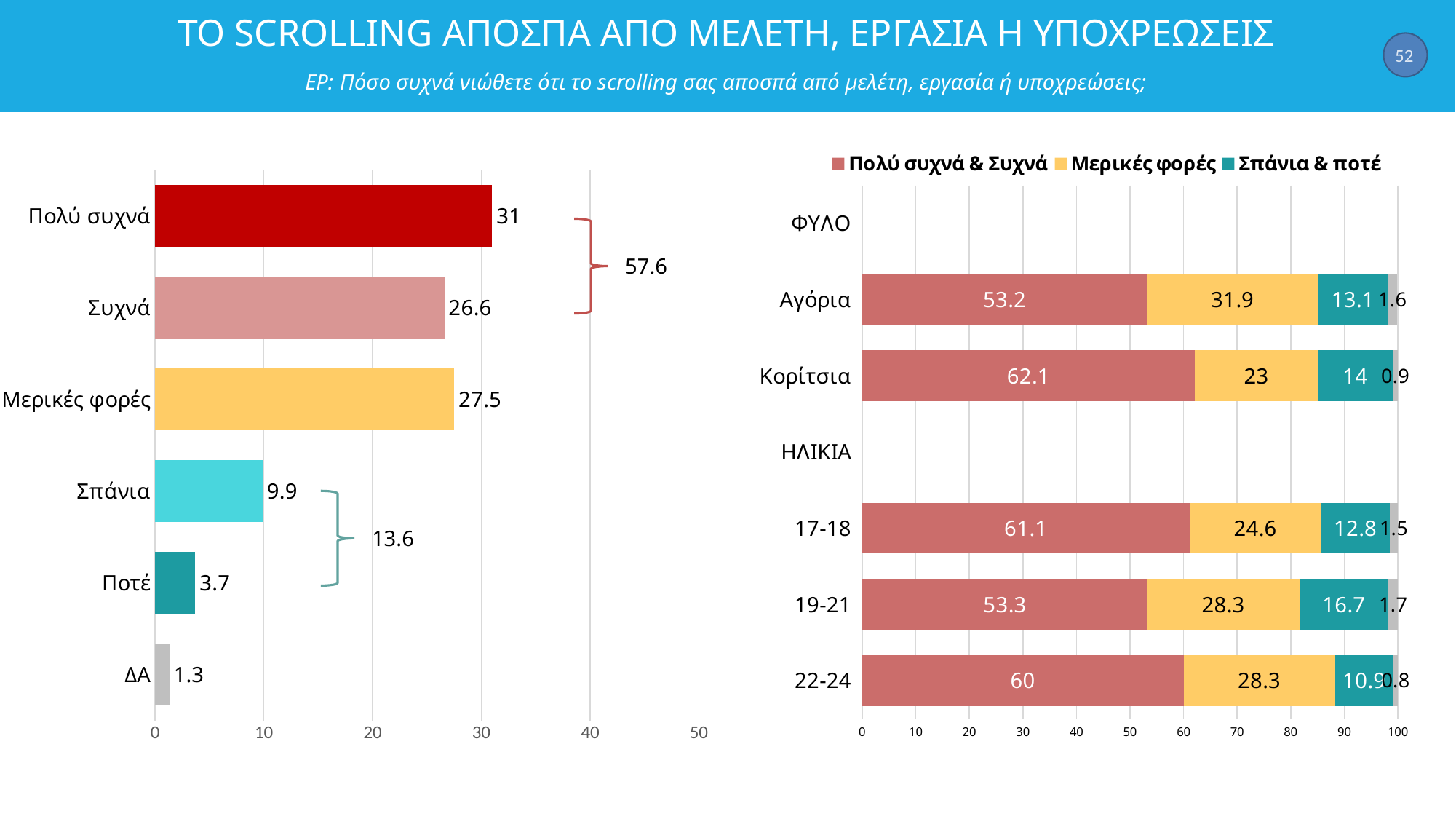
In the right stacked bar chart, what is the Σπάνια & ποτέ value for 19-21? 16.7 In the right stacked bar chart, what is the difference in Πολύ συχνά & Συχνά between Κορίτσια and Αγόρια? 8.9 In the left bar chart, how many categories are shown? 6 In the left bar chart, what is the value for Σπάνια? 9.9 In the left bar chart, which category has the lowest value? ΔΑ In the right stacked bar chart, what is the Πολύ συχνά & Συχνά value for Κορίτσια? 62.1 In the left bar chart, which category has the highest value? Πολύ συχνά In the left bar chart, what is the value for Πολύ συχνά? 31 In the right stacked bar chart, which is larger for Μερικές φορές: Αγόρια or Κορίτσια? Αγόρια What kind of chart is the chart on the right? Stacked bar chart In the left bar chart, what is the difference between Μερικές φορές and Συχνά? 0.9 How many series does the legend of the right chart list? 3